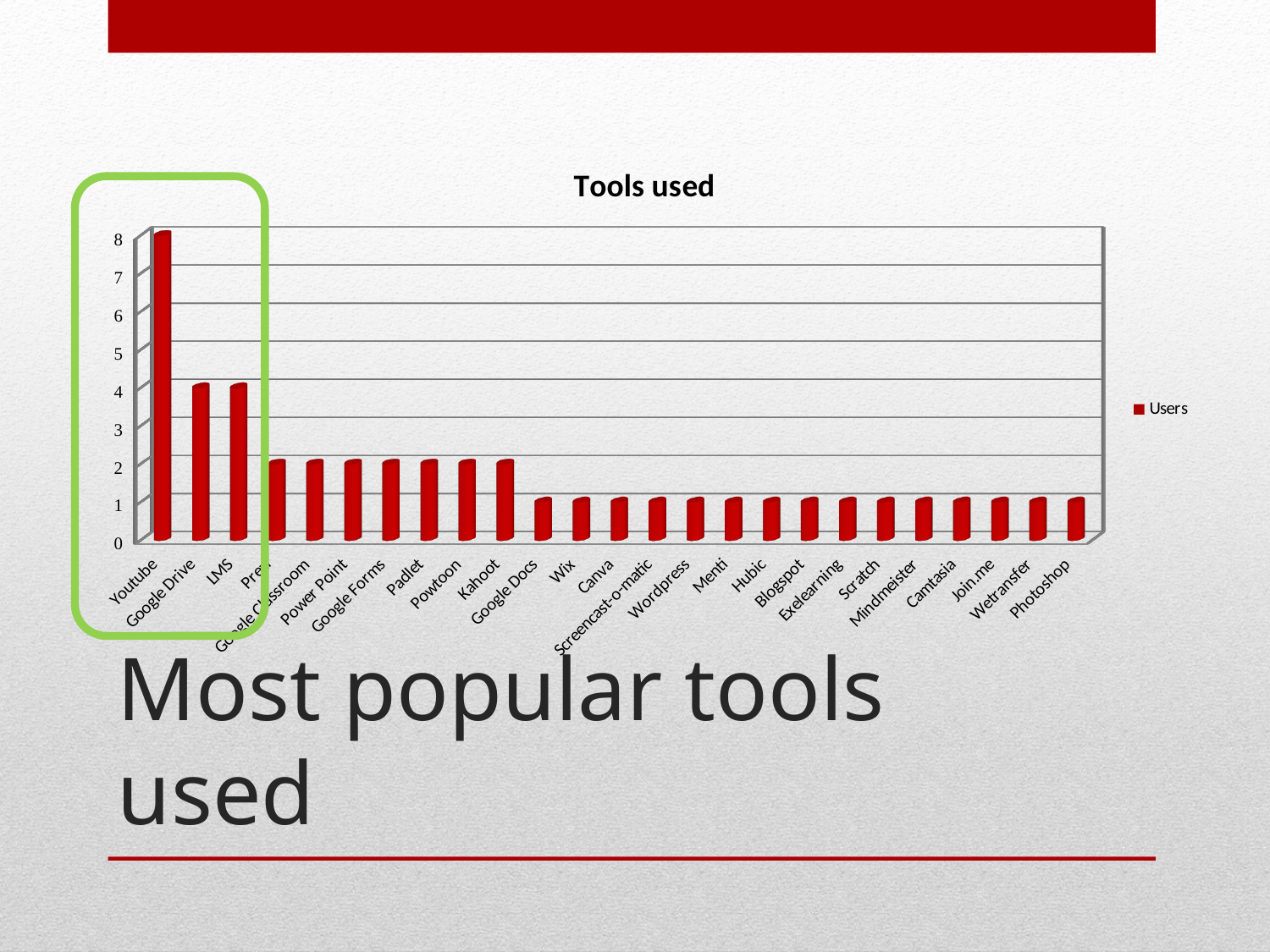
Which tool has the highest number of users? Youtube What is the title of the chart? Tools used How many users does Kahoot have? 2 Which has more users, Padlet or Wix? Padlet What is the difference in users between Youtube and Google Drive? 4 What kind of chart is shown on the slide? bar chart How many tools are shown on the x axis? 25 How many users does Youtube have? 8 How many users does Google Drive have? 4 Is the value for Youtube greater or less than 5? greater How many series does the legend list? 1 How many users does Photoshop have? 1